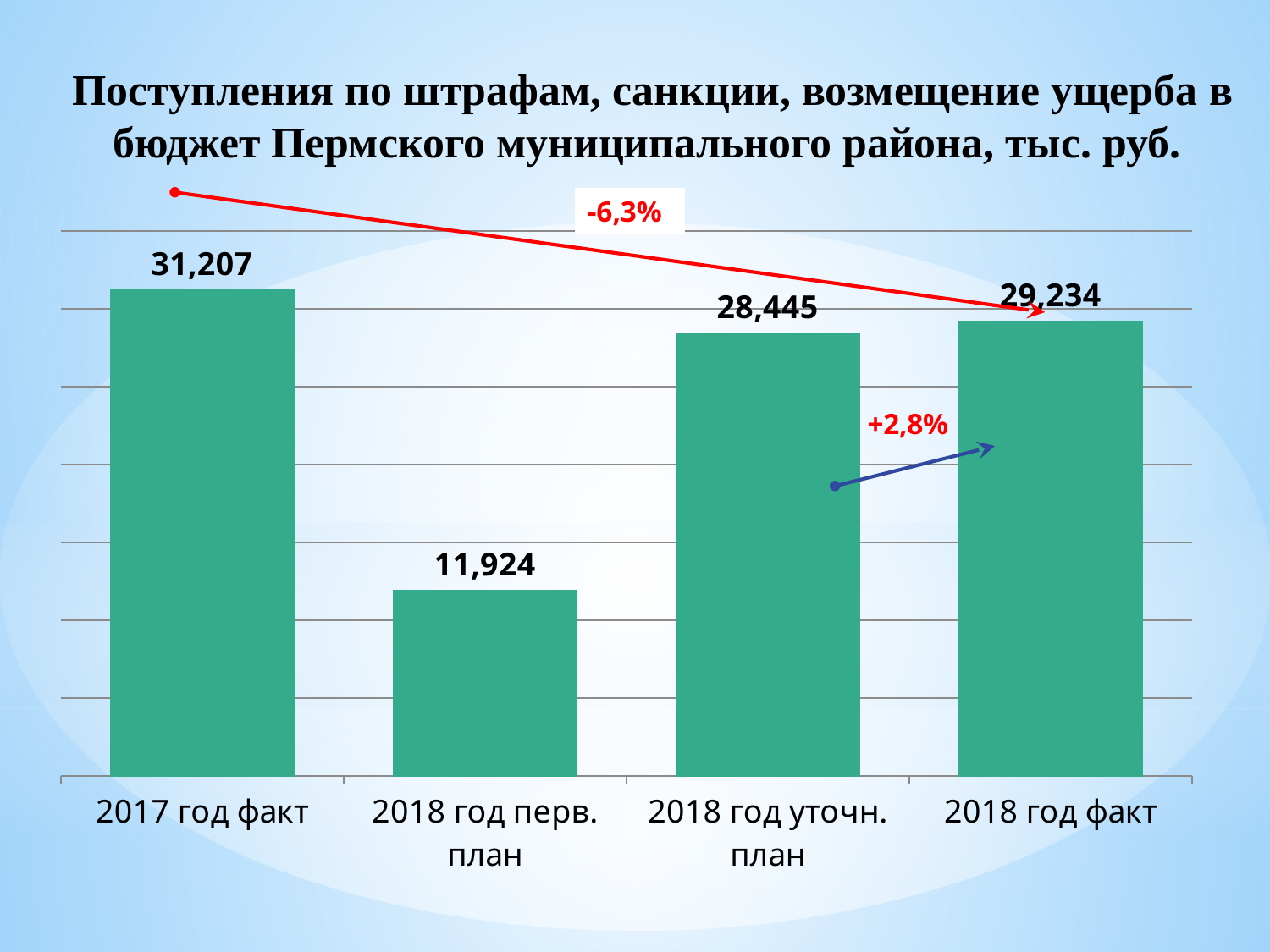
What is the value for 2018 год перв. план? 11,924 Which is larger, the value for 2018 год уточн. план or the value for 2018 год факт? 2018 год факт Which category has the highest value? 2017 год факт What is the value for 2018 год факт? 29,234 What is the value for 2017 год факт? 31,207 What is the difference between the values for 2018 год факт and 2018 год уточн. план? 789 How many categories are shown on the x axis? 4 Which category has the lowest value? 2018 год перв. план What is the value for 2018 год уточн. план? 28,445 What percentage change is shown by the red arrow from 2017 год факт to 2018 год факт? -6,3% What is the difference between the values for 2017 год факт and 2018 год факт? 1,973 What kind of chart is shown on the slide? Bar chart